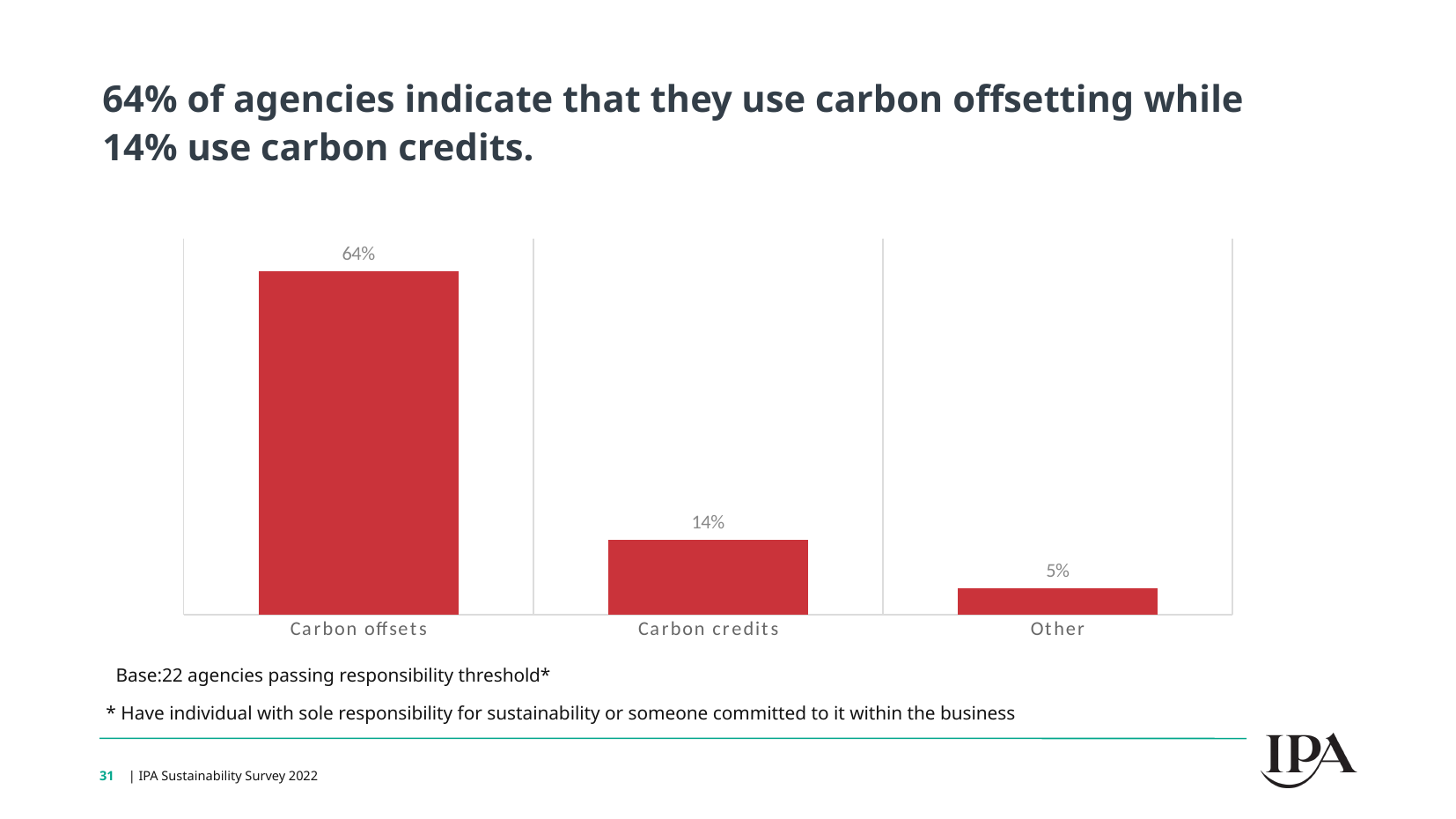
What is the value for Carbon credits? 14% What is the difference between the values for Carbon offsets and Carbon credits? 50% How many categories are shown in the chart? 3 What is the value for Carbon offsets? 64% Which category has the lowest value? Other Which category has the highest value? Carbon offsets What is the value for Other? 5% Which is larger, the value for Carbon credits or the value for Other? Carbon credits What colour are the bars in the chart? Red What is the difference between the values for Carbon credits and Other? 9% What kind of chart is shown on the slide? Bar chart Do the values rise or fall from left to right across the categories? Fall